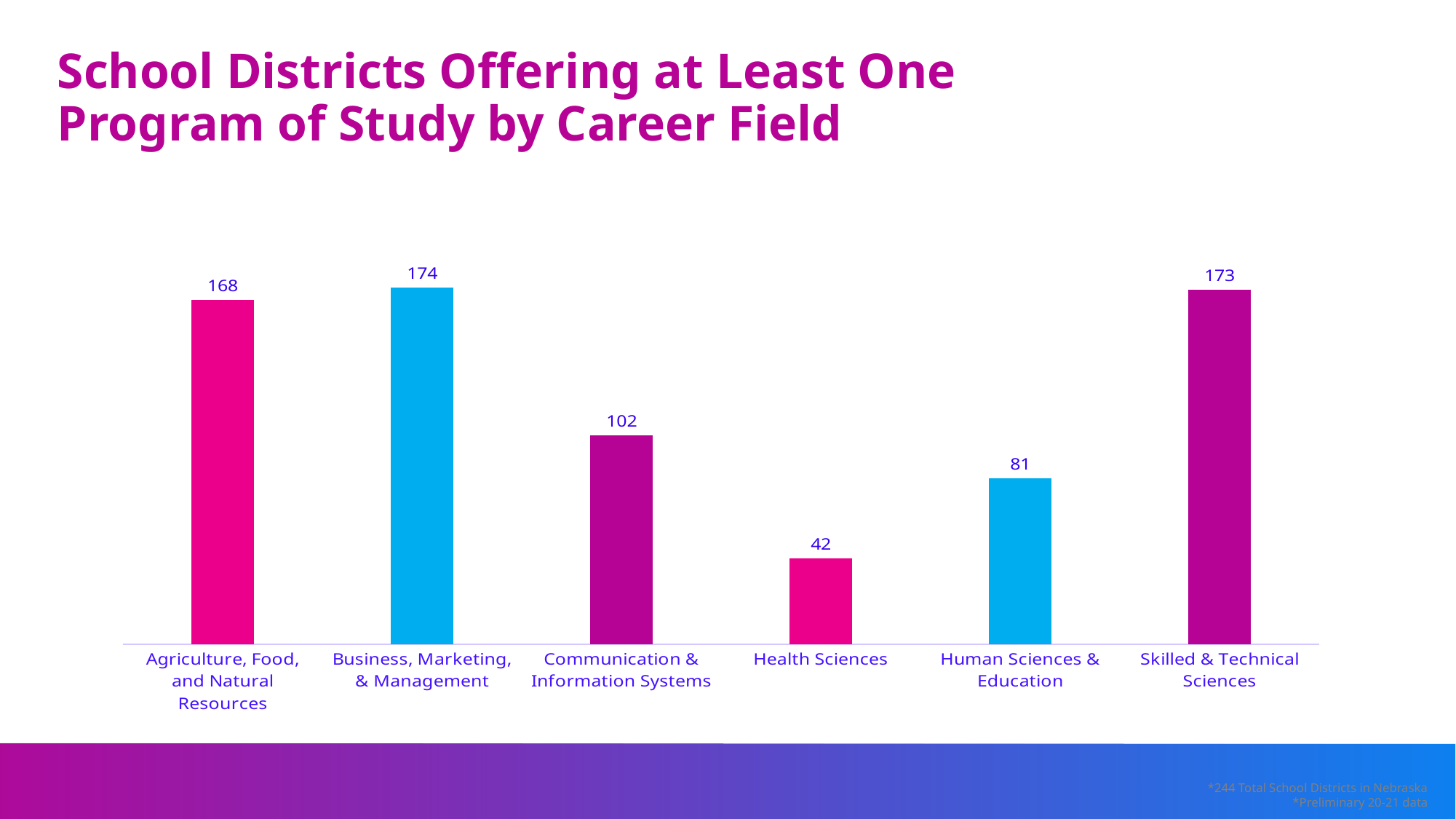
How many career fields are shown in the chart? 6 What kind of chart is shown on the slide? Bar chart Which is larger, the value for Communication & Information Systems or the value for Human Sciences & Education? Communication & Information Systems What is the title of the chart on the slide? School Districts Offering at Least One Program of Study by Career Field What is the value for Human Sciences & Education? 81 Which career field has the highest number of school districts offering at least one program of study? Business, Marketing, & Management Which career field has the lowest value? Health Sciences What is the difference between the values for Communication & Information Systems and Human Sciences & Education? 21 How many school districts offer at least one program of study in Health Sciences? 42 What is the value for Skilled & Technical Sciences? 173 What is the difference between the values for Business, Marketing, & Management and Health Sciences? 132 What is the value for Communication & Information Systems? 102